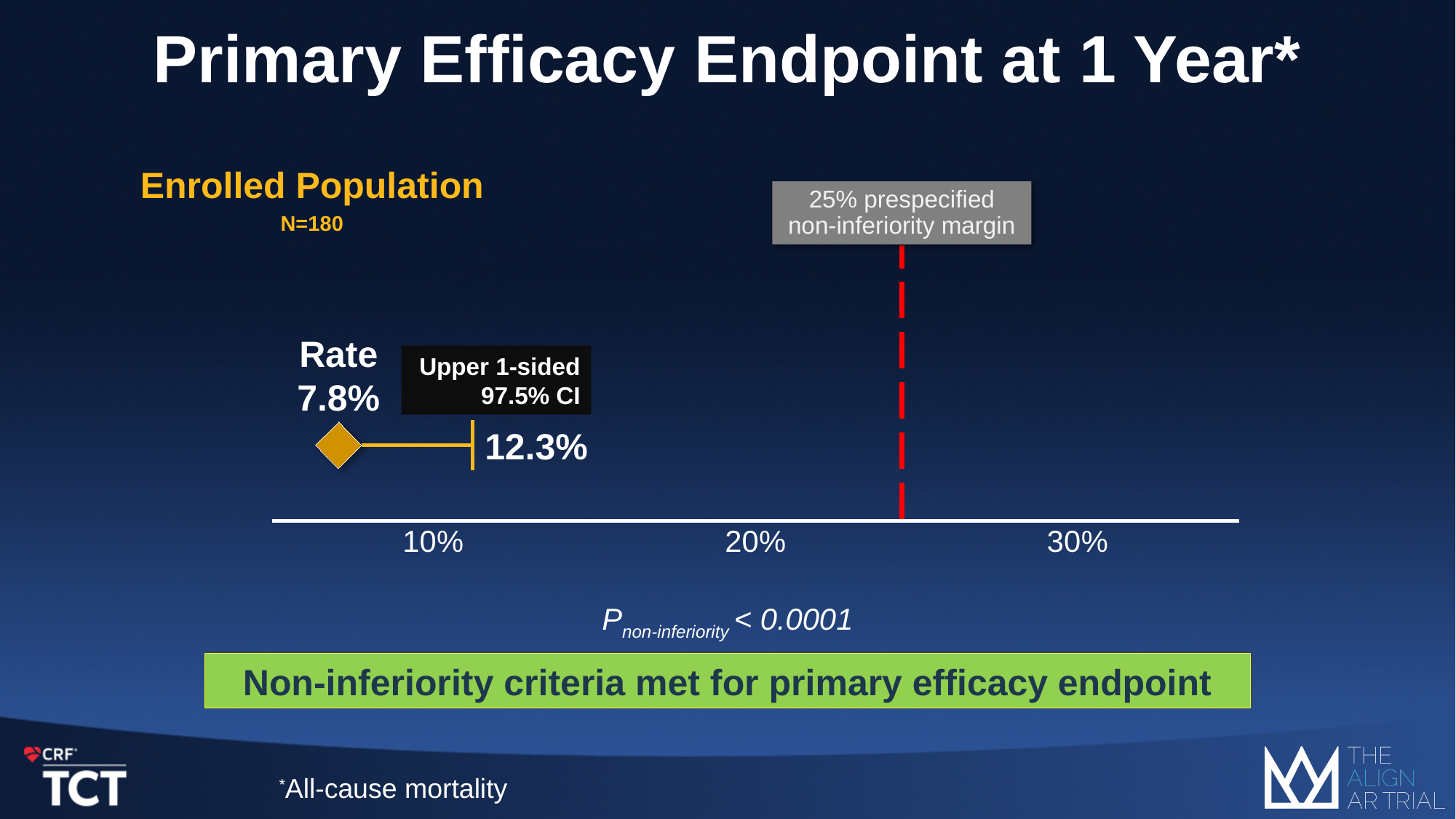
What is the P value for non-inferiority shown below the chart? < 0.0001 How many point estimates (diamond markers) are plotted on the chart? 1 Is the upper 1-sided 97.5% CI bound greater or less than 20%? less What does the red dashed vertical line on the chart represent? 25% prespecified non-inferiority margin Which is larger, the upper 1-sided 97.5% CI bound or the prespecified non-inferiority margin? the non-inferiority margin By how much is the 25% non-inferiority margin above the upper CI bound of 12.3%? 12.7% What is the upper 1-sided 97.5% CI value shown on the chart? 12.3% Is the rate for the Enrolled Population greater or less than 10%? less What is the rate for the Enrolled Population shown by the diamond marker? 7.8% What is the difference between the upper 1-sided 97.5% CI (12.3%) and the rate (7.8%)? 4.5% What is the prespecified non-inferiority margin marked by the red dashed line? 25% What is the highest percentage tick label shown on the x axis? 30%